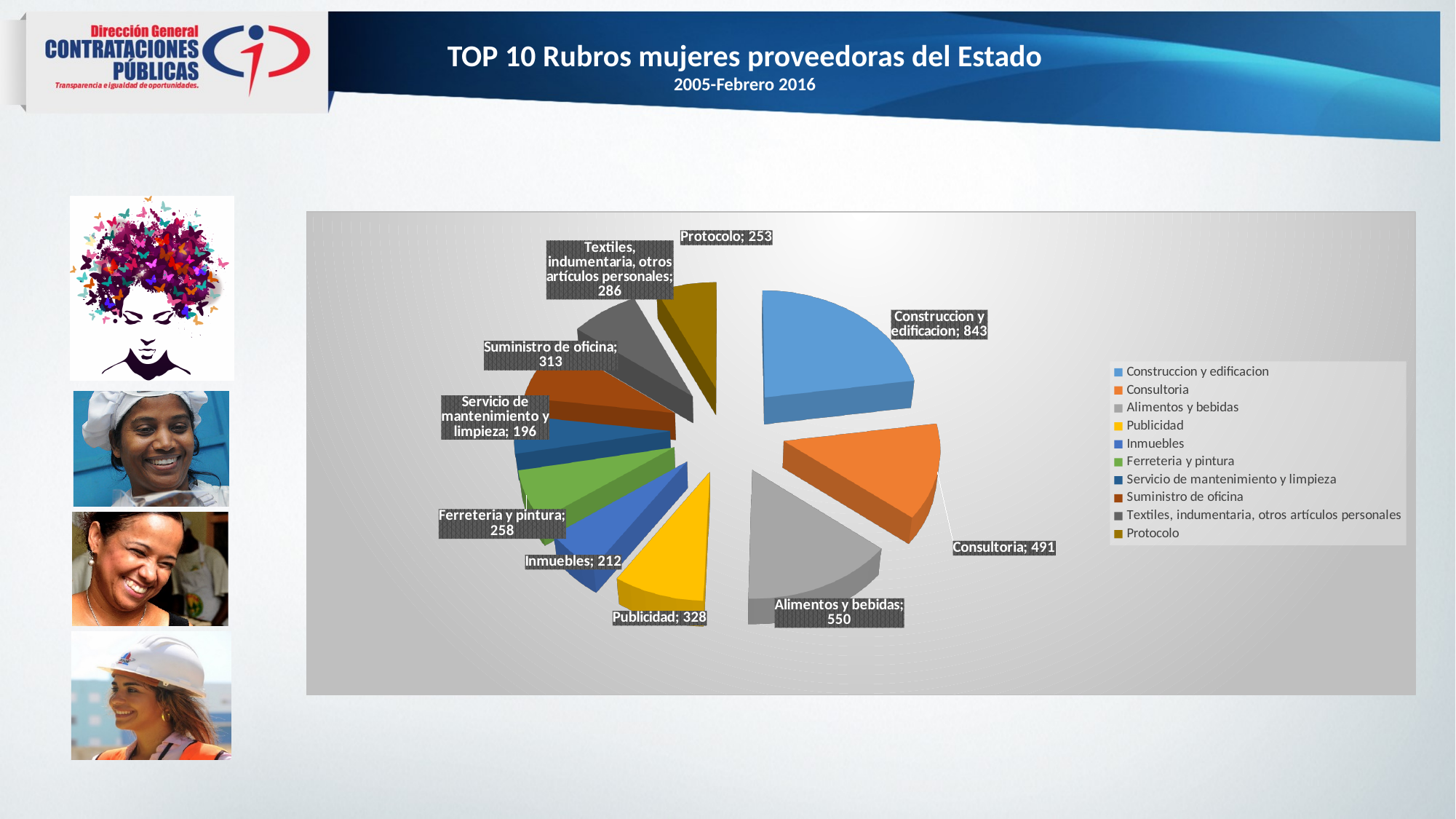
What is the value for Alimentos y bebidas? 550 How many categories does the pie chart have? 10 Which category has the largest slice? Construccion y edificacion What kind of chart is shown on the slide? Pie chart What is the difference between the values for Consultoria and Publicidad? 163 What is the value for Servicio de mantenimiento y limpieza? 196 What is the value for Construccion y edificacion? 843 What is the title of the slide containing the chart? TOP 10 Rubros mujeres proveedoras del Estado Which category has the smallest slice? Servicio de mantenimiento y limpieza What is the value for Textiles, indumentaria, otros artículos personales? 286 Which is larger, Suministro de oficina or Protocolo? Suministro de oficina